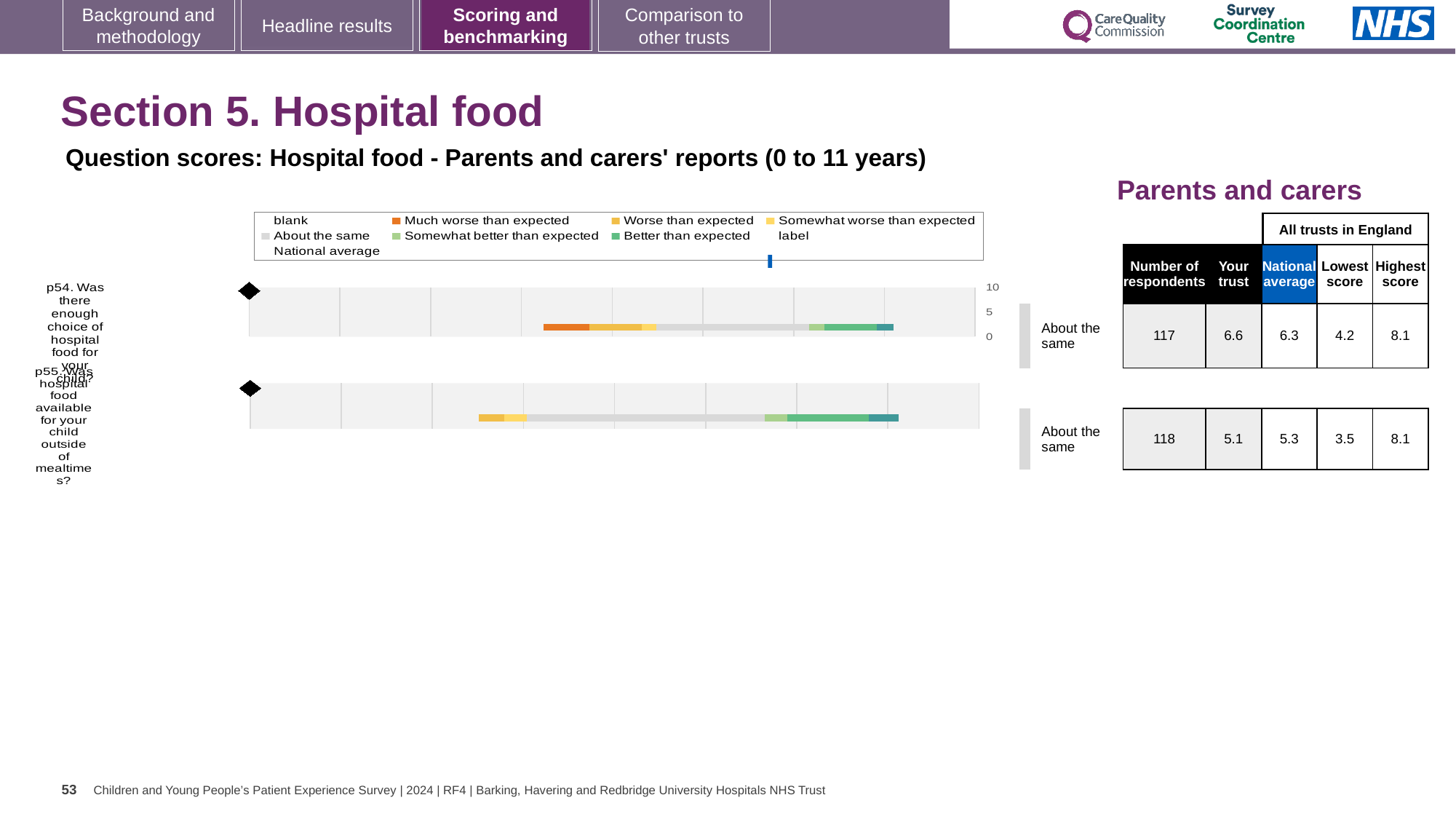
In the table beside the chart, what is the lowest score for p54? 4.2 What is the highest value shown on the chart's axis? 10 What benchmark label is shown next to the bar for p54? About the same How many entries does the chart legend list? 9 In the table beside the chart, what is the national average for p55? 5.3 In the table beside the chart, what is the 'Your trust' score for p54? 6.6 How many questions (bars) are plotted in the chart? 2 For p54, which is larger: the 'Your trust' score or the national average? Your trust For p54, what is the difference between the 'Your trust' score and the national average? 0.3 In the table beside the chart, how many respondents answered p55? 118 What kind of chart is shown on the slide? bar chart For p55, what is the difference between the highest score and the lowest score in the table? 4.6